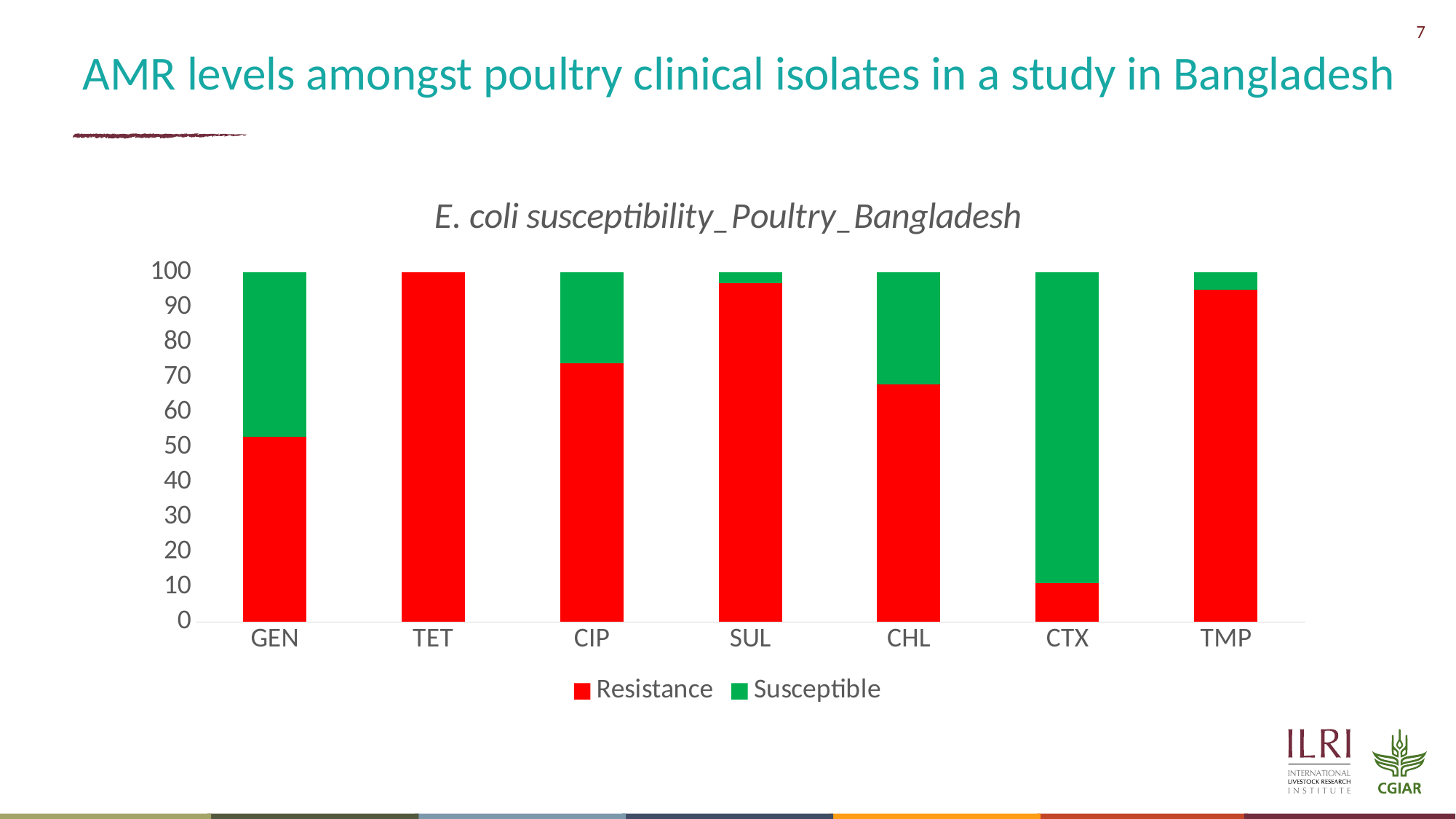
What is the Resistance value for TET? 100 Which has the larger Resistance value, GEN or CIP? CIP Which antibiotic has the lowest Resistance value? CTX Is the Resistance value for CHL greater or less than 70? less Which antibiotic has the largest Susceptible value? CTX How many series does the legend list? 2 Is the Resistance value for CTX greater or less than 20? less What is the title of the chart? E. coli susceptibility_Poultry_Bangladesh Which antibiotic has the highest Resistance value? TET What kind of chart is shown on the slide? bar chart Which colour represents the Resistance series? red How many antibiotic categories are shown on the x axis? 7